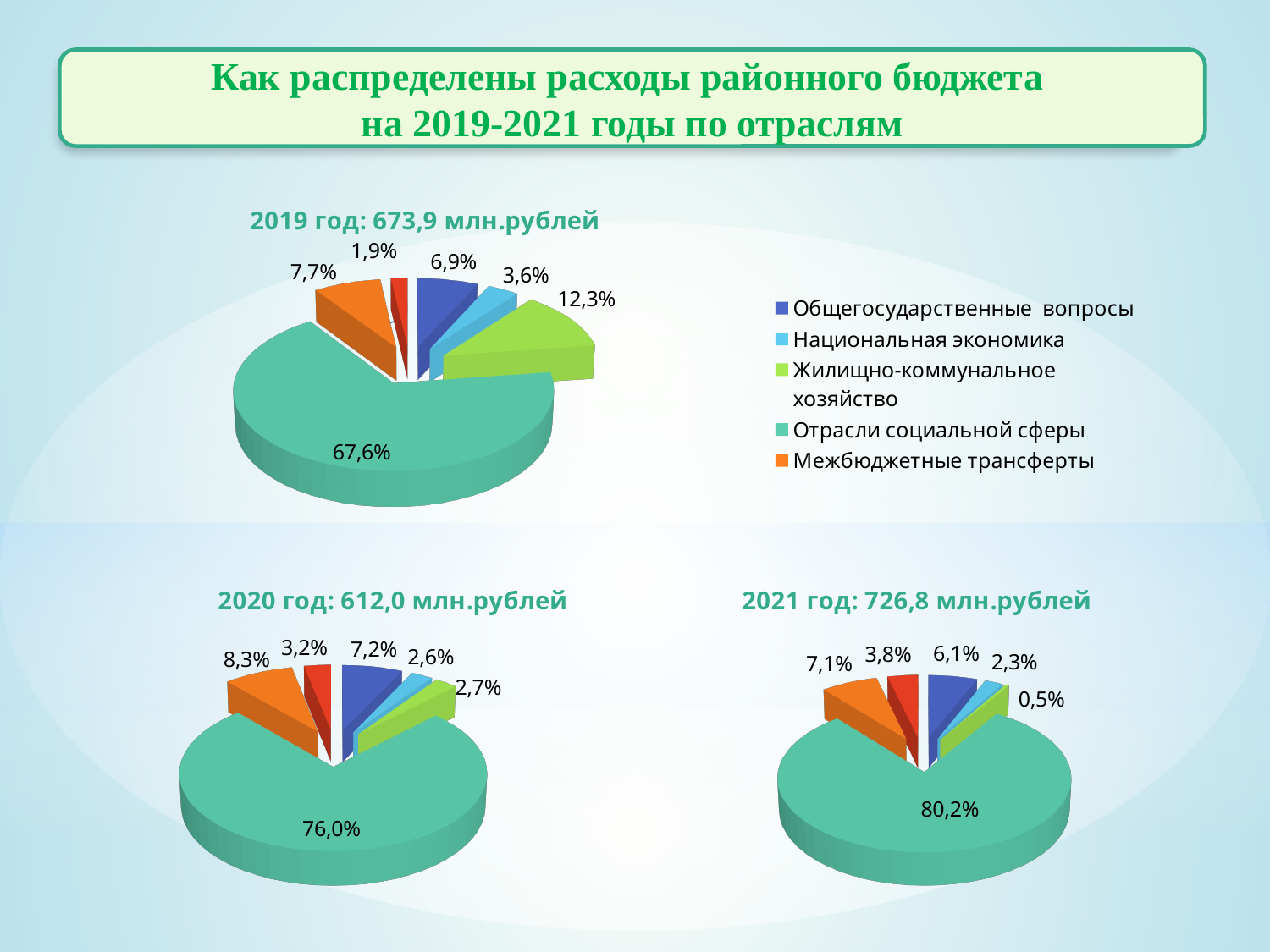
In the 2019 chart, what share of expenditures goes to Отрасли социальной сферы? 67,6% What type of chart is used for the 2020 data? Pie chart What total amount is given in the title of the 2021 chart? 726,8 млн.рублей In the 2021 chart, what share is shown for Общегосударственные вопросы? 6,1% How many entries does the legend list? 5 In the 2019 chart, what share is shown for Жилищно-коммунальное хозяйство? 12,3% In the 2021 chart, which legend category has the smallest share? Жилищно-коммунальное хозяйство In the 2021 chart, which category has the largest share? Отрасли социальной сферы In the 2020 chart, what is the difference between the shares of Общегосударственные вопросы and Национальная экономика? 4,6% In the 2019 chart, which is larger: the share of Межбюджетные трансферты or the share of Общегосударственные вопросы? Межбюджетные трансферты What colour represents Отрасли социальной сферы in the legend? Teal (green-blue) In the 2020 chart, what share is shown for Межбюджетные трансферты? 8,3%